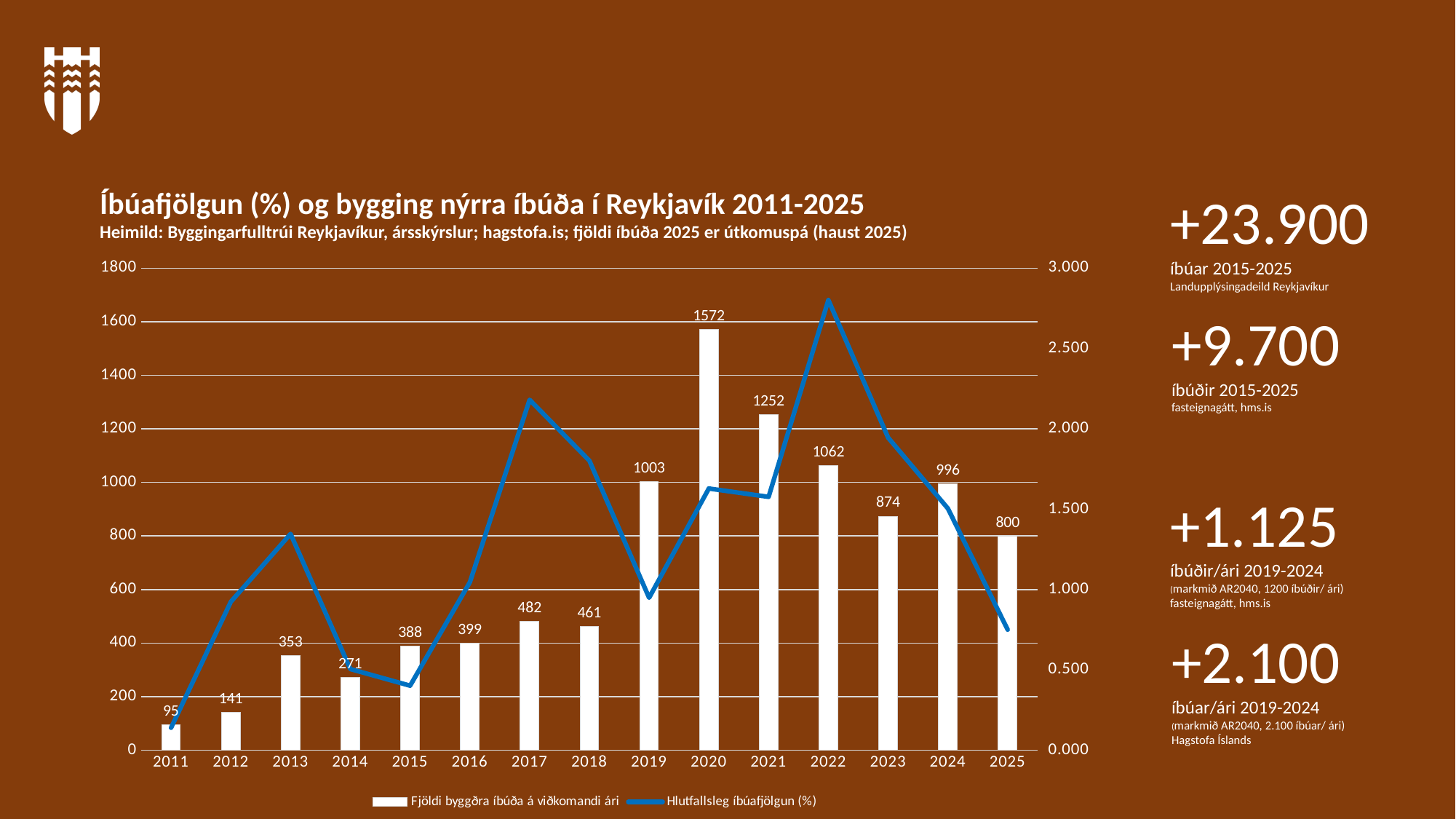
What is the value of the bar for 2017? 482 Do the bar values rise or fall from 2011 to 2013? rise What is the difference between the number of apartments built in 2020 and in 2021? 320 Which year has a higher bar value, 2023 or 2024? 2024 How many years are shown on the x axis of the chart? 15 Which year has the highest number of built apartments? 2020 Which year has the lowest number of built apartments? 2011 Is the value of the percentage population growth line for 2022 greater or less than 2.500? greater How many new apartments were built in Reykjavík in 2020 according to the chart? 1572 What kind of chart is shown on the slide? Combined bar and line chart Is the value of the percentage population growth line for 2015 greater or less than 0.500? less How many series does the legend list? 2